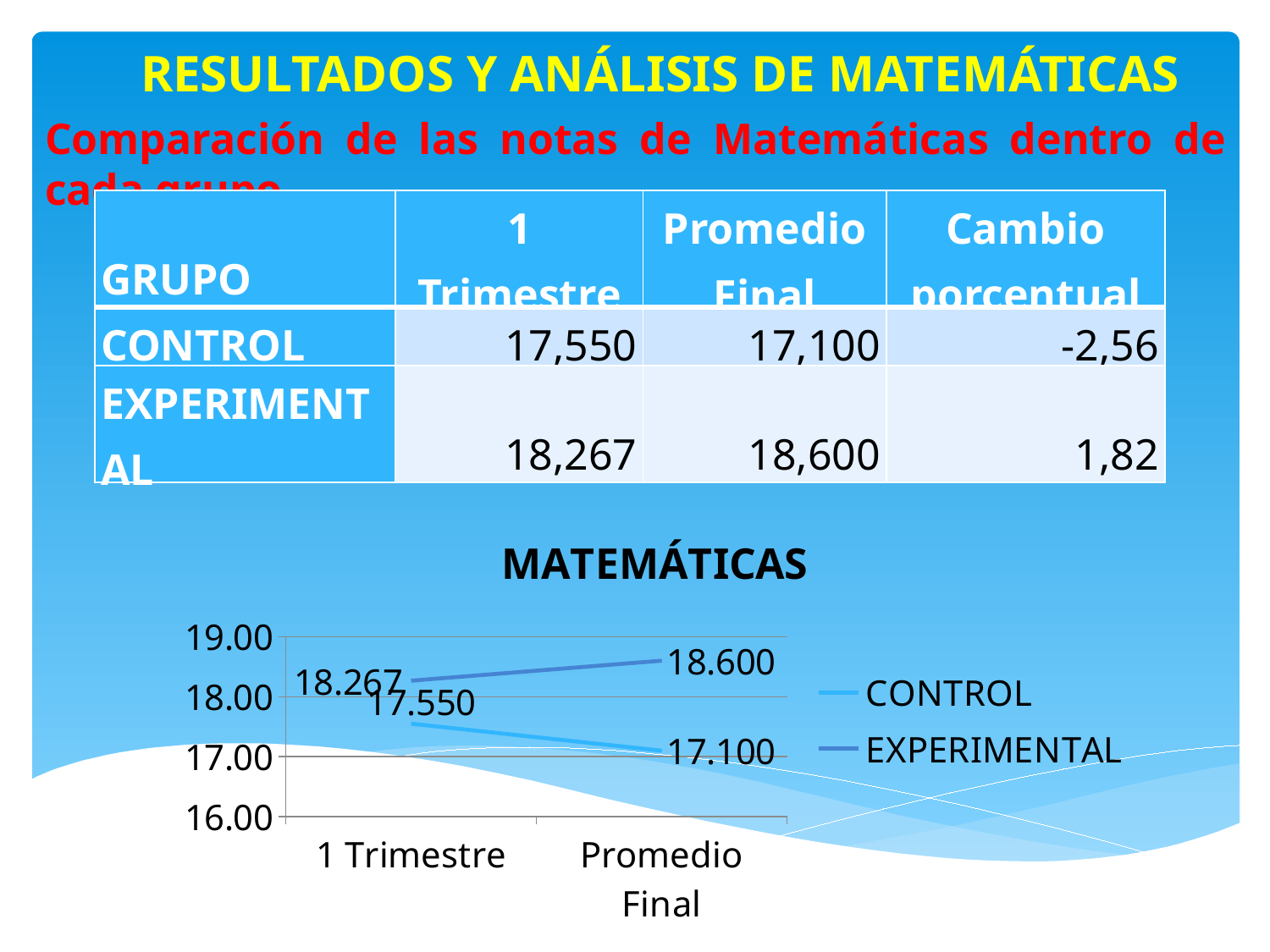
What is the value for EXPERIMENTAL at 1 Trimestre in the chart? 18.267 What type of chart is shown on the slide? line chart How many series does the chart legend list? 2 What is the value for CONTROL at 1 Trimestre in the chart? 17.550 What is the difference between the EXPERIMENTAL and CONTROL values at Promedio Final? 1.500 What is the value for EXPERIMENTAL at Promedio Final in the chart? 18.600 What is the value for CONTROL at Promedio Final in the chart? 17.100 Does the CONTROL line rise or fall from 1 Trimestre to Promedio Final? fall Does the EXPERIMENTAL line rise or fall from 1 Trimestre to Promedio Final? rise How many categories are shown on the x axis of the chart? 2 Which series has the higher value at Promedio Final, CONTROL or EXPERIMENTAL? EXPERIMENTAL What is the title of the chart? MATEMÁTICAS